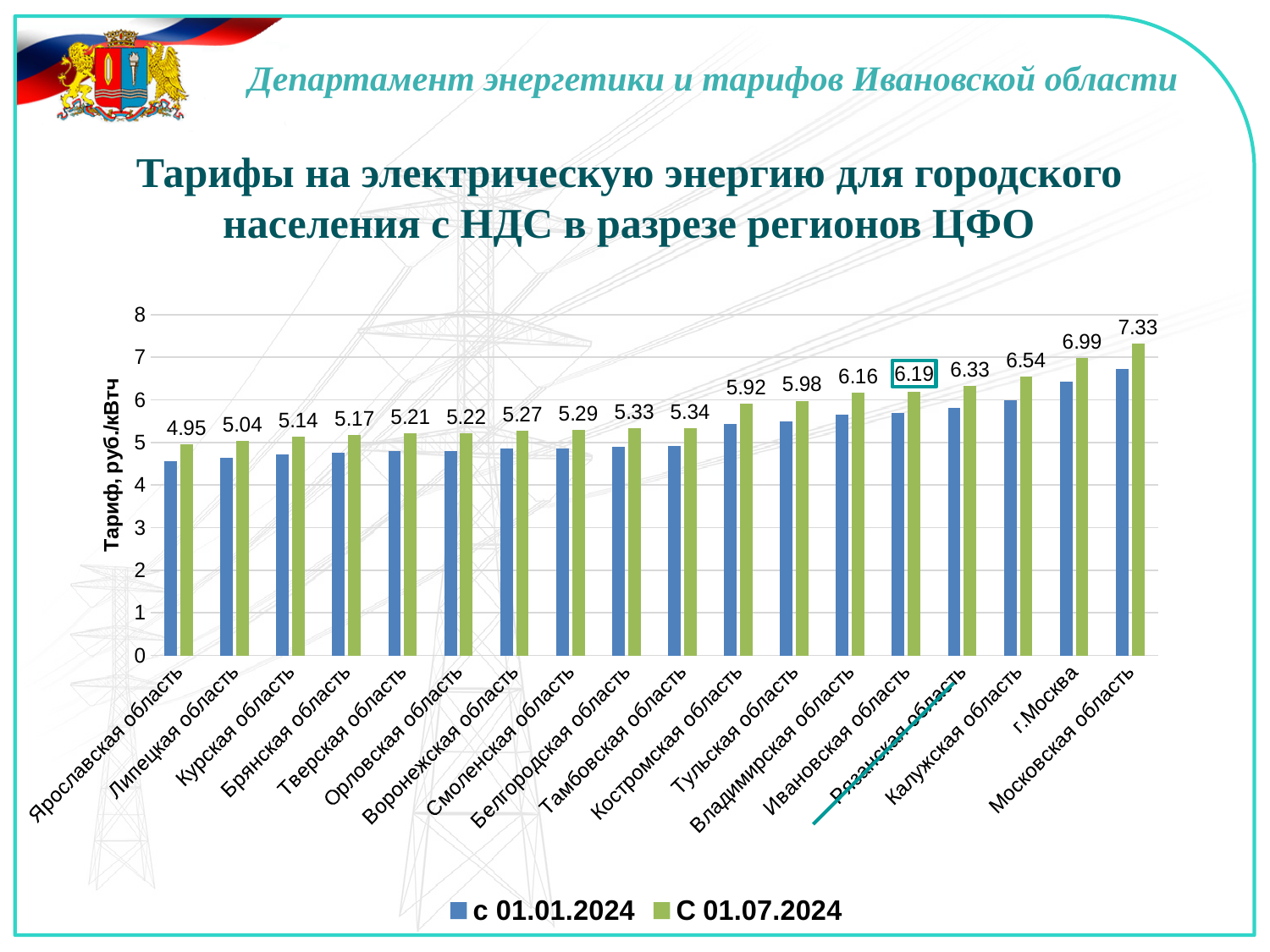
How many regions are shown on the x axis? 18 Which region has the highest value in the С 01.07.2024 series? Московская область How many series does the legend list? 2 What is the value for Ивановская область in the С 01.07.2024 series? 6.19 Is the value for Тульская область in the с 01.01.2024 series greater or less than 6? less What is the label of the y axis? Тариф, руб./кВтч What is the value for г.Москва in the С 01.07.2024 series? 6.99 Which is larger in the С 01.07.2024 series: Калужская область or Владимирская область? Калужская область What kind of chart is shown on the slide? bar chart Which region has the lowest value in the С 01.07.2024 series? Ярославская область What is the difference between the С 01.07.2024 values for Московская область and Ярославская область? 2.38 What is the value for Московская область in the С 01.07.2024 series? 7.33